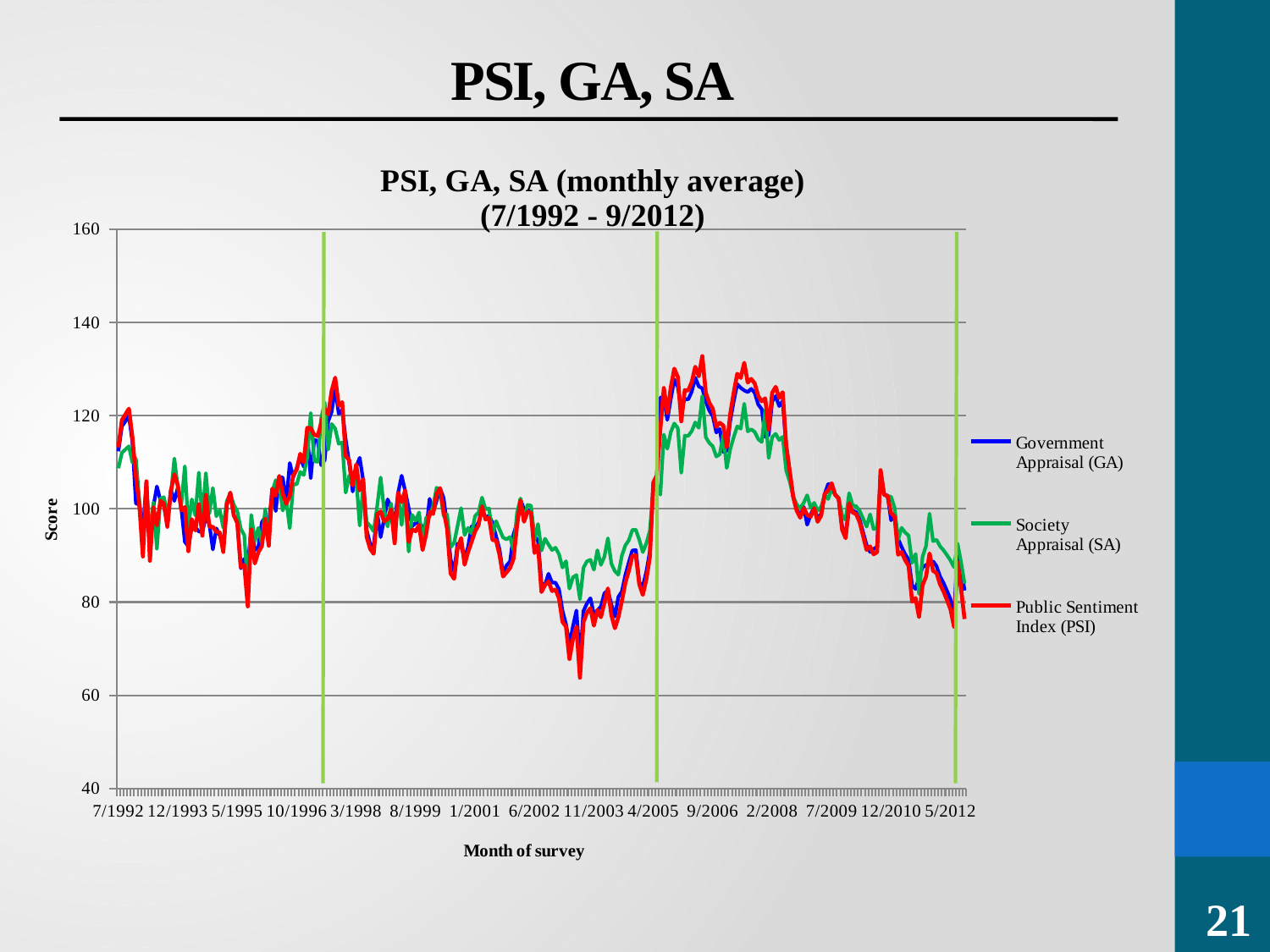
Is the value of the Government Appraisal (GA) at the end of the series (around 9/2012) greater or less than 100? less Is the value of the Public Sentiment Index (PSI) at 7/1992 greater or less than 100? greater Is the value of the Public Sentiment Index (PSI) around 11/2003 greater or less than 80? less What is the label of the vertical axis? Score Do the values generally rise or fall between 7/2009 and 5/2012? fall Which series reaches the highest peak on the chart? Public Sentiment Index (PSI) How many series does the legend list? 3 Which series reaches the lowest point on the chart? Public Sentiment Index (PSI) What kind of chart is shown on the slide? line chart What is the title of the chart? PSI, GA, SA (monthly average) (7/1992 - 9/2012)